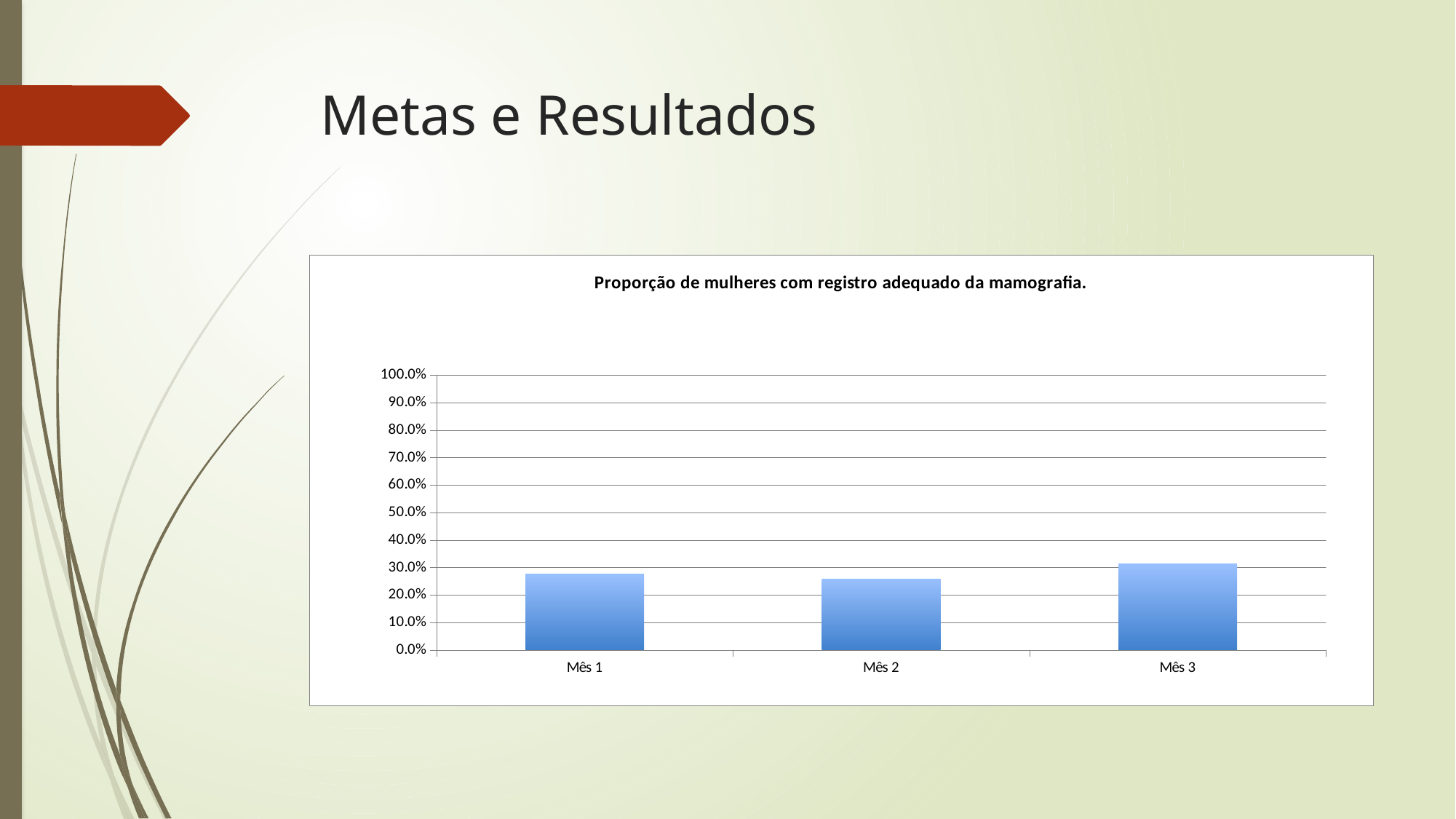
What is the title of the chart? Proporção de mulheres com registro adequado da mamografia. What colour are the bars on the chart? blue How many categories (months) are plotted on the chart? 3 Which month has the highest value on the chart? Mês 3 Which is larger, the value for Mês 3 or the value for Mês 1? Mês 3 What kind of chart is shown on the slide? bar chart Is the value for Mês 2 greater or less than 20.0%? greater Does the value rise or fall from Mês 2 to Mês 3? rise Is the value for Mês 3 greater or less than 40.0%? less Is the value for Mês 1 greater or less than 30.0%? less Which is larger, the value for Mês 3 or the value for Mês 2? Mês 3